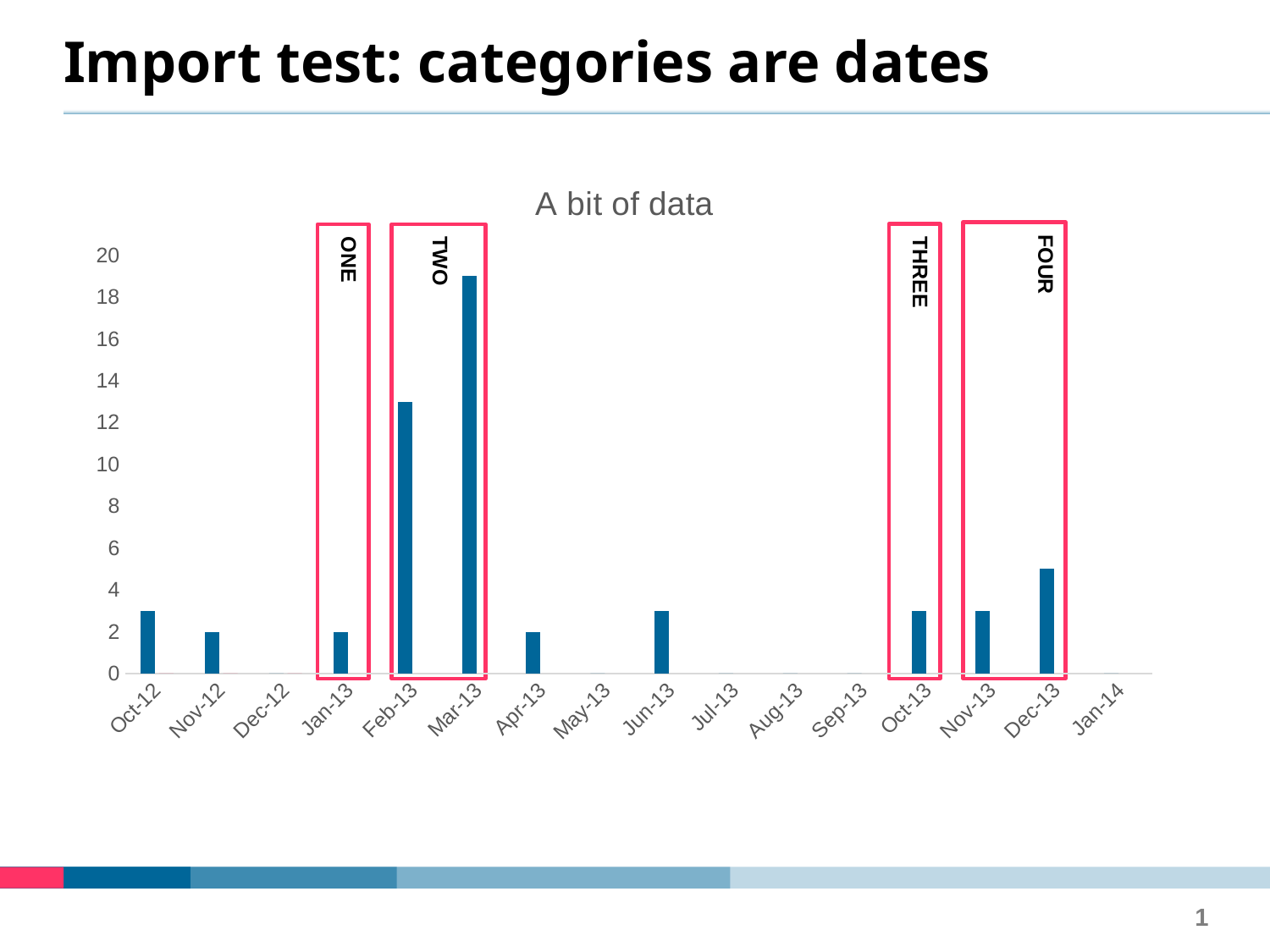
Which is larger, the value for Feb-13 or the value for Mar-13? Mar-13 How many red boxes with labels (ONE, TWO, THREE, FOUR) are drawn over the chart? 4 Which month has the highest bar in the chart? Mar-13 Which is larger, the value for Dec-13 or the value for Oct-13? Dec-13 What kind of chart is shown on the slide? bar chart How many month categories are shown on the x axis? 16 Is the value for Feb-13 greater or less than 12? greater What is the title of the chart? A bit of data Is the value for Dec-13 greater or less than 4? greater Is the value for Oct-12 greater or less than 4? less